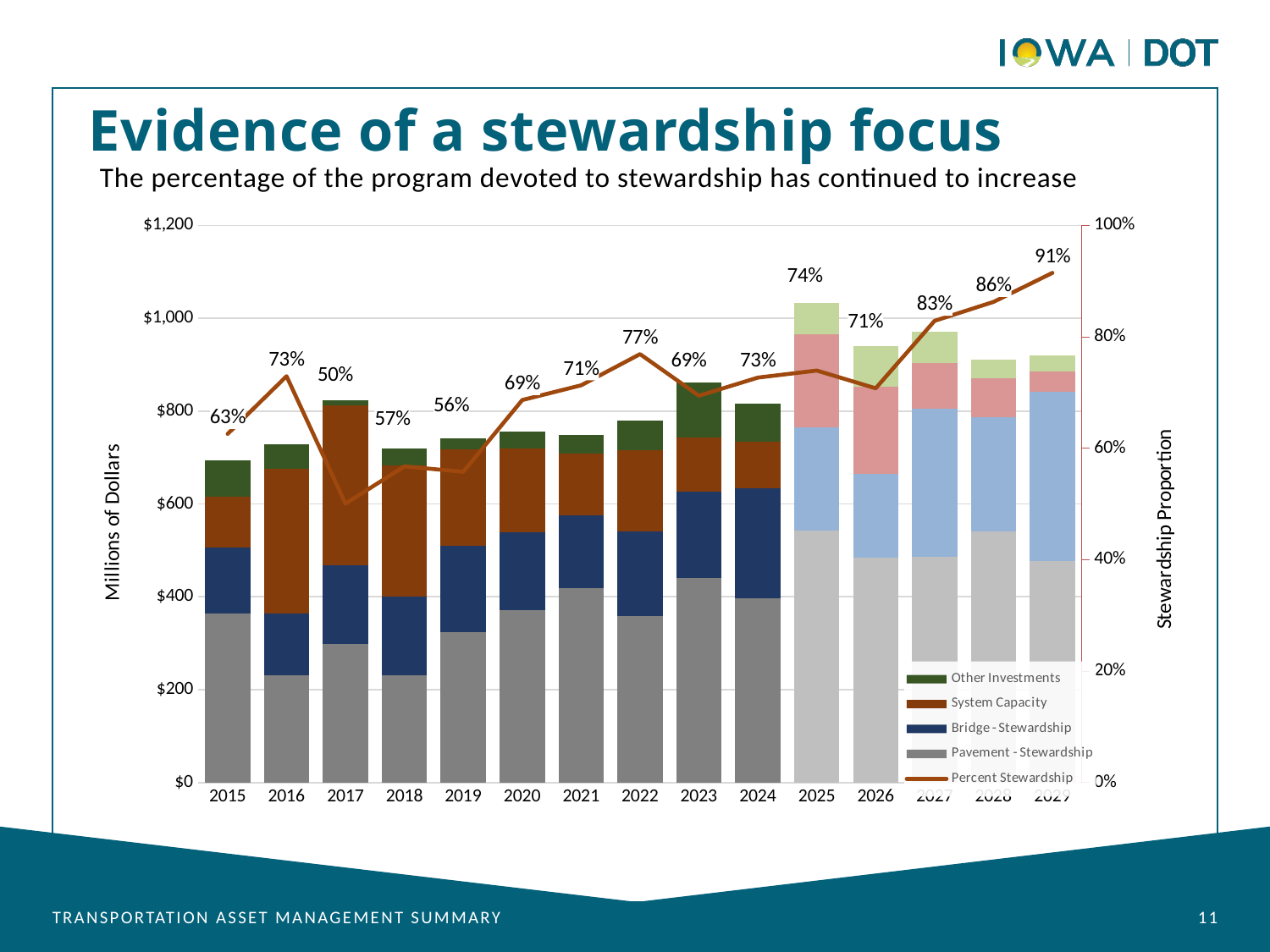
What is the Percent Stewardship value for 2029? 91% Which year has the lowest Percent Stewardship value? 2017 Which year has the highest Percent Stewardship value? 2029 What is the Percent Stewardship value for 2017? 50% Is the total stacked bar value for 2015 greater or less than $800 million? less Does the Percent Stewardship line rise or fall from 2026 to 2029? rise Which year has a higher Percent Stewardship value, 2016 or 2019? 2016 By how many percentage points does the Percent Stewardship value in 2029 exceed the value in 2015? 28 percentage points How many series does the legend list? 5 How many years are shown on the x axis of the chart? 15 Is the total stacked bar value for 2029 greater or less than $1,000 million? less What is the Percent Stewardship value for 2022? 77%